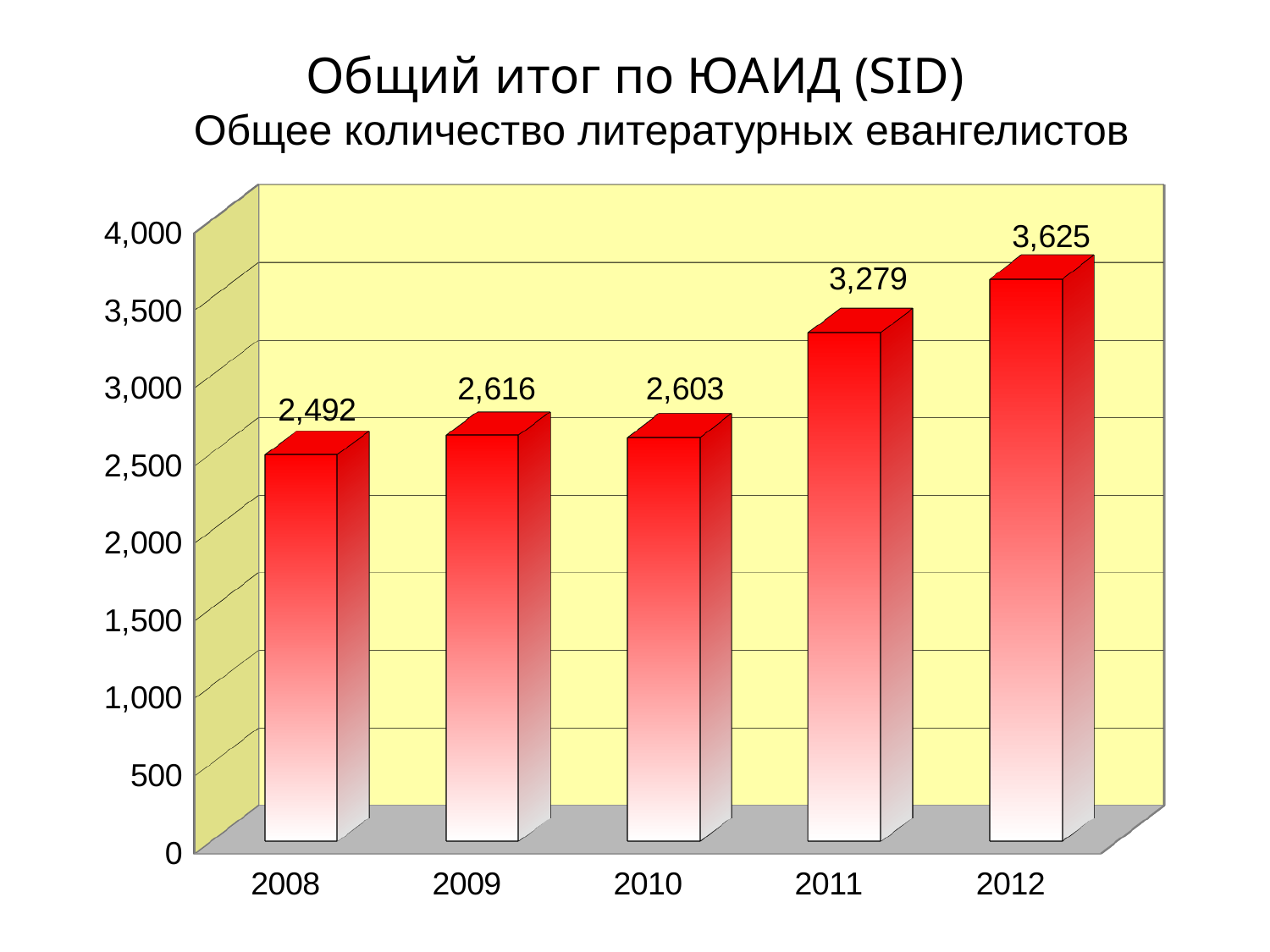
What is the difference between the values for 2009 and 2008? 124 Is the value for 2011 greater or less than 3,000? greater Do the values generally rise or fall from 2008 to 2012? rise What is the value for 2011? 3,279 How many years are shown on the x axis? 5 What is the value for 2008? 2,492 What is the value for 2010? 2,603 Which year has the highest value? 2012 Which is larger, the value for 2009 or the value for 2010? 2009 What kind of chart is shown on the slide? bar chart What is the difference between the values for 2012 and 2011? 346 Which year has the lowest value? 2008